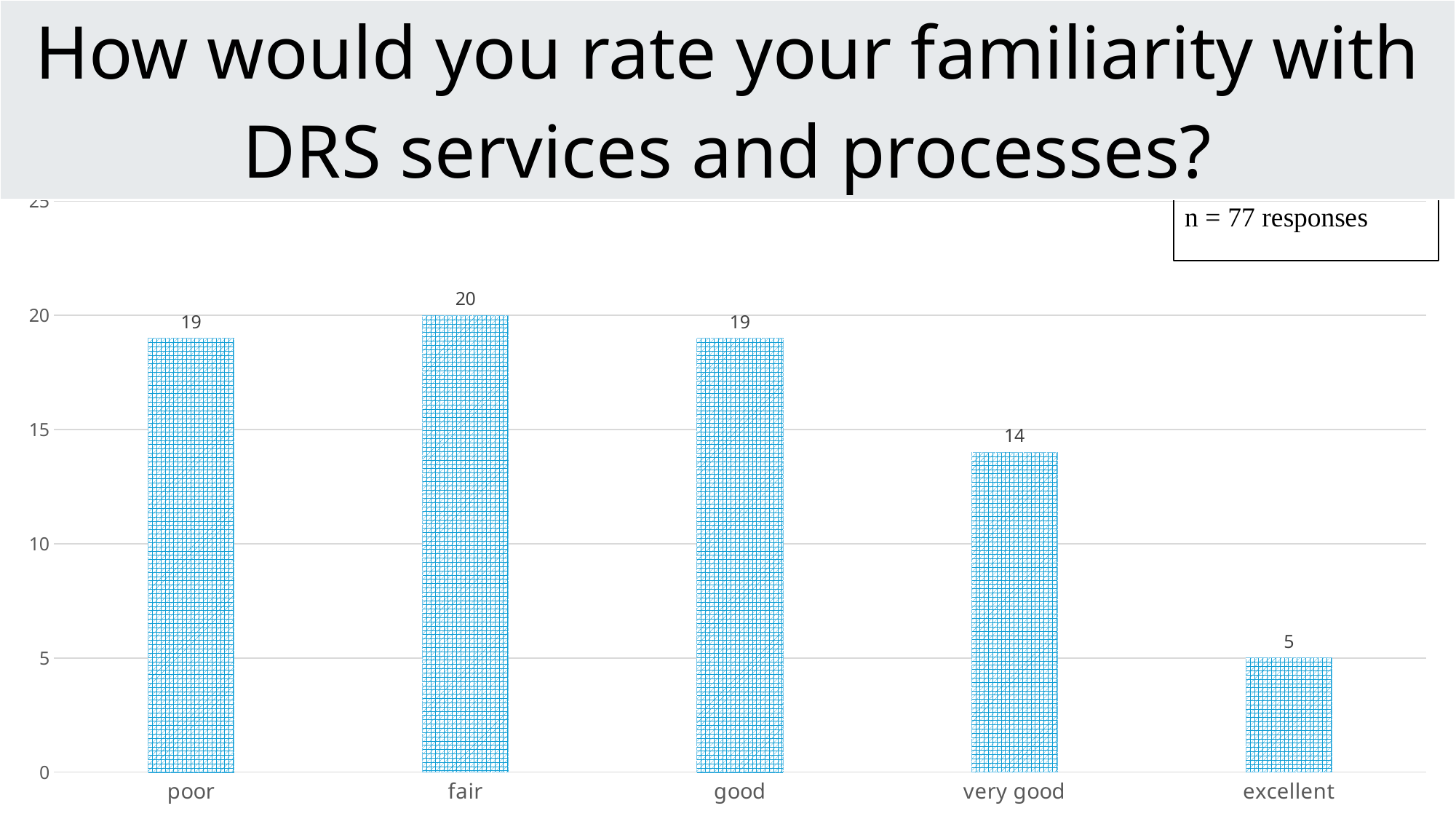
Which category has the lowest value? excellent What is the value for the 'fair' category? 20 What is the value for the 'excellent' category? 5 What kind of chart is shown on the slide? bar chart Which is larger, the value for 'very good' or the value for 'excellent'? very good What is the difference between the values for 'fair' and 'excellent'? 15 What is the value for the 'very good' category? 14 How many responses does the note on the chart say were collected? 77 What is the difference between the values for 'very good' and 'excellent'? 9 Is the value for 'very good' greater or less than 10? greater Which category has the highest value? fair How many categories are shown on the x axis? 5